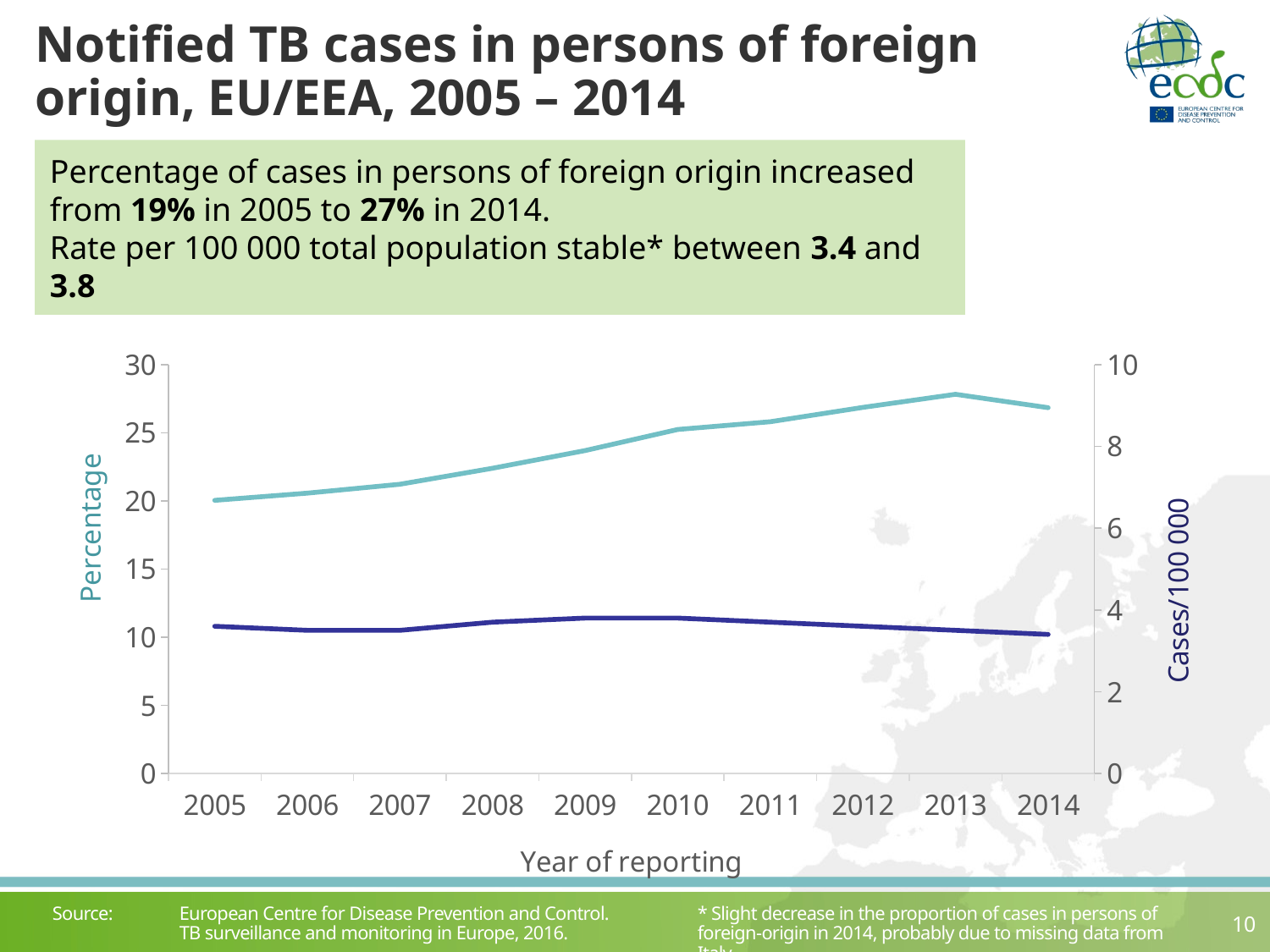
Is the Percentage value for 2013 greater or less than 25? greater What kind of chart is shown on the slide? line chart What is the label of the right-hand y axis? Cases/100 000 How many years of reporting are plotted along the x axis? 10 In which year of reporting is the Percentage line at its highest? 2013 Is the Cases/100 000 value for 2009 greater or less than 4? less Which year has the larger Percentage value, 2005 or 2010? 2010 Does the Percentage line generally rise or fall from 2005 to 2013? rise What is the title of the x axis? Year of reporting Is the Cases/100 000 value for 2014 greater or less than 2? greater In which year of reporting is the Percentage line at its lowest? 2005